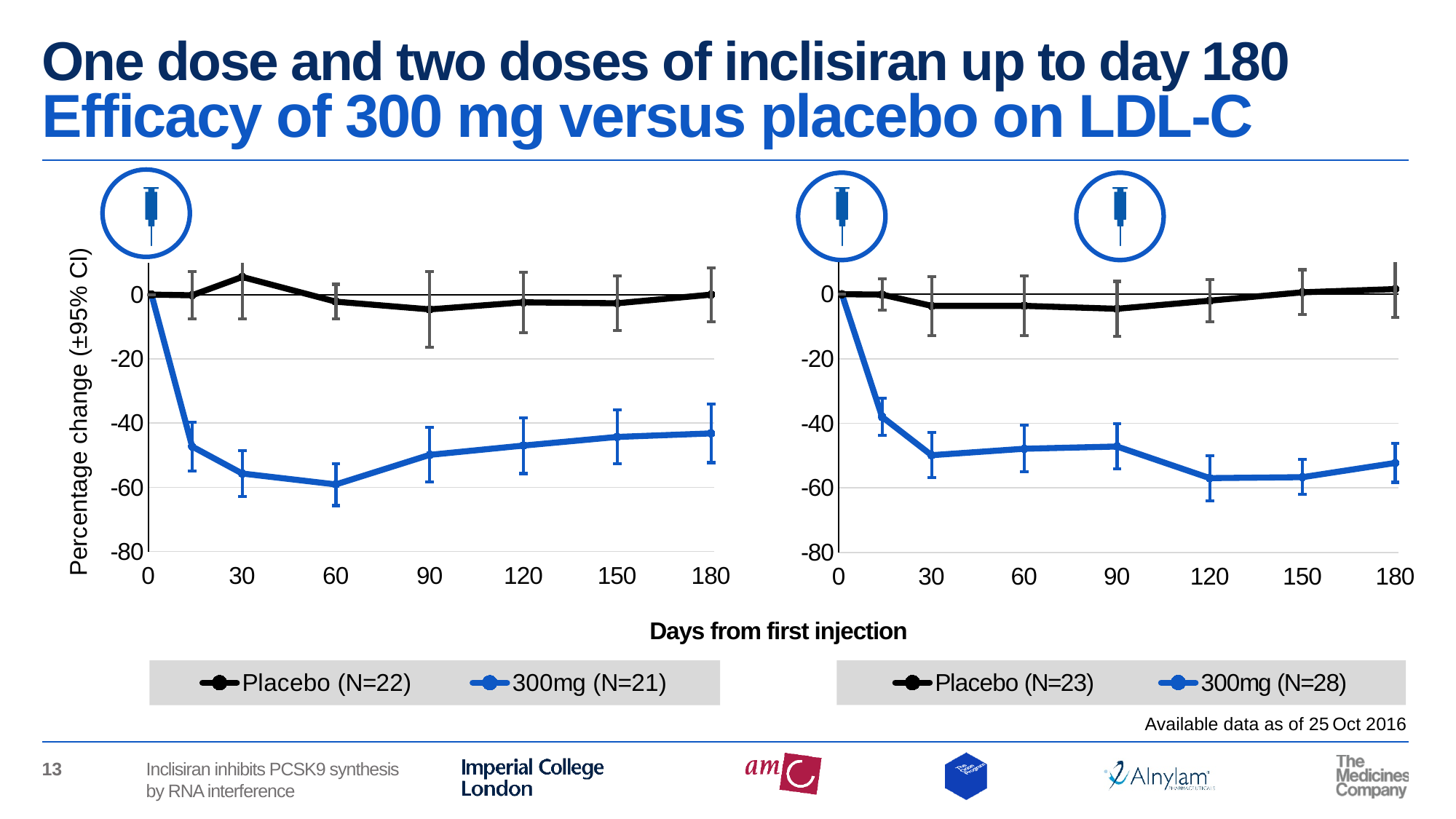
In the left chart, which is lower for the 300mg series: the value at day 60 or the value at day 180? day 60 In the right chart, is the value for 300mg at day 120 greater or less than -40? less In the left chart, does the 300mg series rise or fall from day 60 to day 180? rise In the right chart, what is the N for the placebo group shown in the legend? N=23 In the right chart, is the value for placebo at day 90 greater or less than -20? greater How many series does the legend of the right chart list? 2 In the left chart, what is the N for the 300mg group shown in the legend? N=21 What kind of chart is the left chart? line chart In the left chart, at which day does the 300mg series reach its lowest value? 60 In the left chart, is the value for 300mg at day 60 greater or less than -40? less In the right chart, which series has the lower value at day 180, placebo or 300mg? 300mg